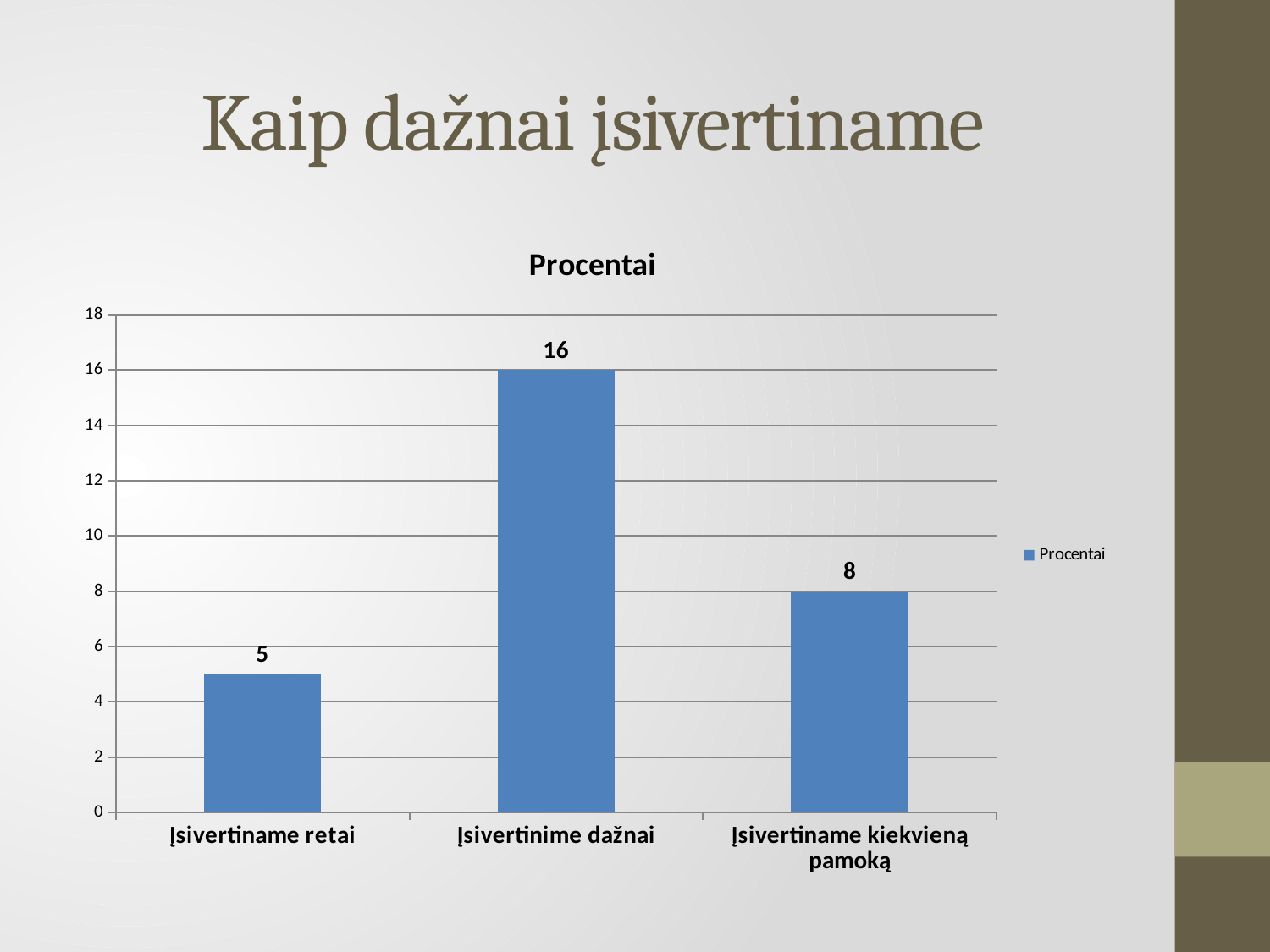
What is the value for Įsivertiname kiekvieną pamoką? 8 What is the difference between the values for Įsivertinime dažnai and Įsivertiname kiekvieną pamoką? 8 Which category has the lowest value? Įsivertiname retai Is the value for Įsivertinime dažnai greater or less than 10? greater Which is larger, the value for Įsivertiname retai or the value for Įsivertiname kiekvieną pamoką? Įsivertiname kiekvieną pamoką What kind of chart is shown on the slide? bar chart How many categories are shown on the x axis? 3 What is the title of the chart? Procentai Which category has the highest value? Įsivertinime dažnai What is the value for Įsivertinime dažnai? 16 What is the difference between the values for Įsivertiname kiekvieną pamoką and Įsivertiname retai? 3 What is the value for Įsivertiname retai? 5